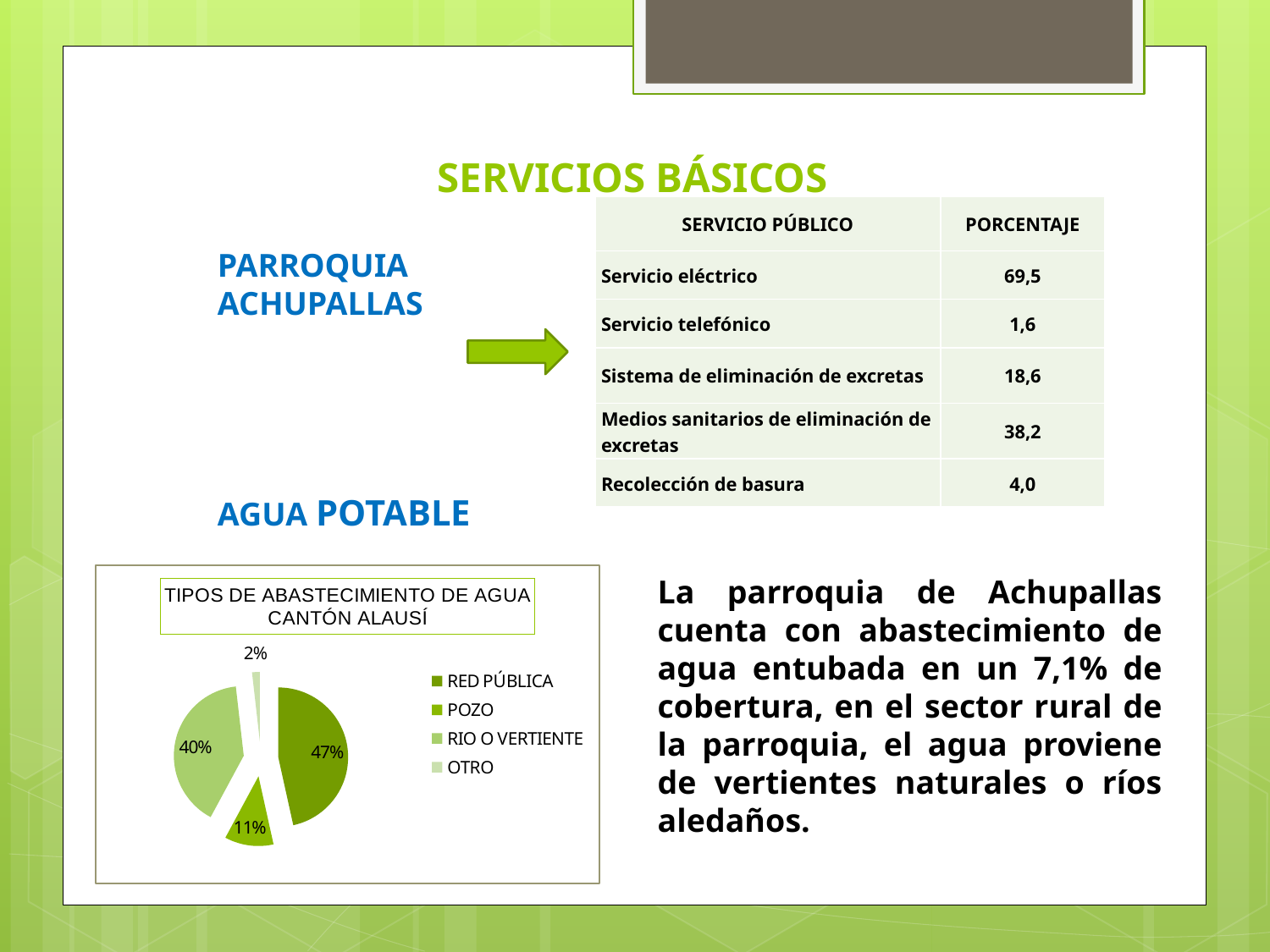
How many entries does the legend of the pie chart list? 4 What share of the pie chart does OTRO represent? 2% What is the title of the pie chart? TIPOS DE ABASTECIMIENTO DE AGUA CANTÓN ALAUSÍ Which is larger in the pie chart, POZO or RIO O VERTIENTE? RIO O VERTIENTE What share of the pie chart does RED PÚBLICA represent? 47% What is the difference in percentage points between RED PÚBLICA and RIO O VERTIENTE in the pie chart? 7 What share of the pie chart does RIO O VERTIENTE represent? 40% Which category has the largest slice in the pie chart? RED PÚBLICA What type of chart is shown on the slide? pie chart Which category has the smallest slice in the pie chart? OTRO How many categories does the pie chart show? 4